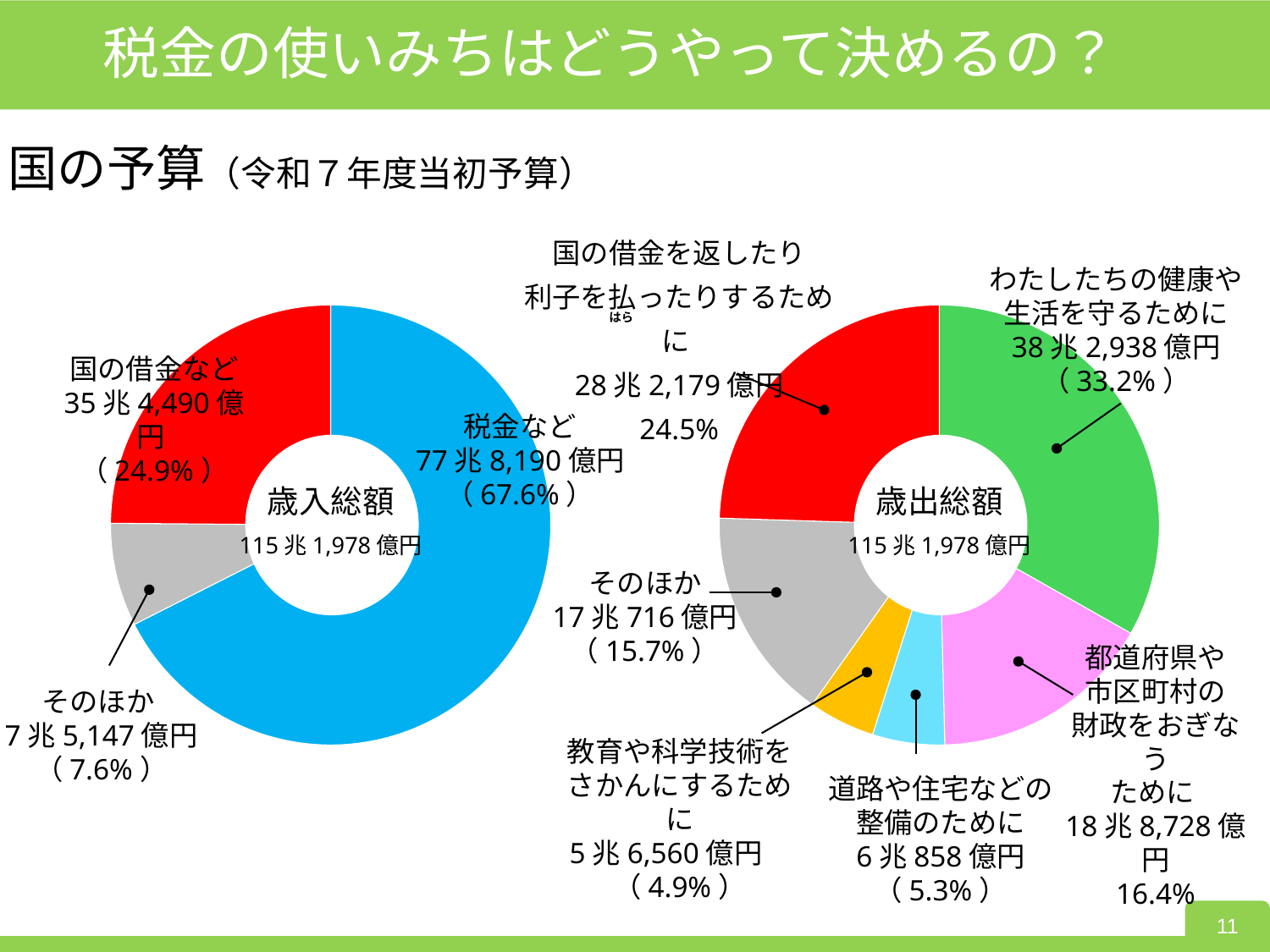
左の「歳入総額」のグラフで、「国の借金など」の割合は何％ですか？ 24.9% 左の「歳入総額」のグラフで、「税金など」の金額はいくらですか？ 77兆8,190億円 左の「歳入総額」のグラフで、最も割合が小さい項目はどれですか？ そのほか 右の「歳出総額」のグラフで、「道路や住宅などの整備のために」の割合は何％ですか？ 5.3% 右の「歳出総額」のグラフには、いくつの項目がありますか？ 6 右の「歳出総額」のグラフで、「わたしたちの健康や生活を守るために」と「国の借金を返したり利子を払ったりするために」の割合の差は何ポイントですか？ 8.7ポイント 右の「歳出総額」のグラフで、最も割合が小さい項目はどれですか？ 教育や科学技術をさかんにするために 右の「歳出総額」のグラフで、「わたしたちの健康や生活を守るために」の金額はいくらですか？ 38兆2,938億円 右の「歳出総額」のグラフで、「そのほか」と「都道府県や市区町村の財政をおぎなうために」では、どちらの割合が大きいですか？ 都道府県や市区町村の財政をおぎなうために このスライドのグラフはどの種類のグラフですか？ 円グラフ（ドーナツグラフ） 左の「歳入総額」のグラフには、いくつの項目がありますか？ 3 左の「歳入総額」のグラフで、最も割合が大きい項目はどれですか？ 税金など